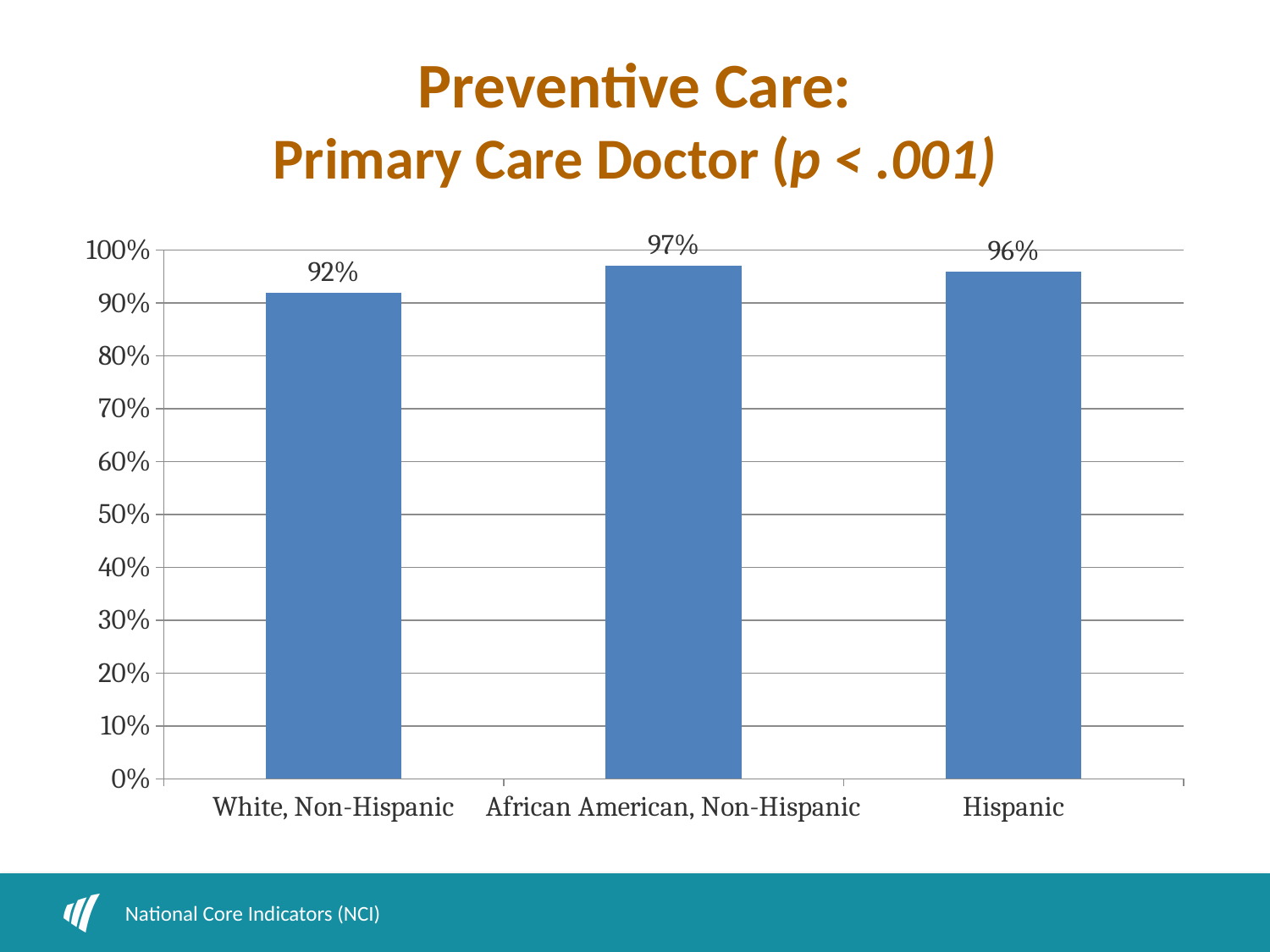
How many categories are shown on the x axis? 3 What is the difference between the values for African American, Non-Hispanic and White, Non-Hispanic? 5% Which category has the lowest value? White, Non-Hispanic What is the title of the chart on the slide? Preventive Care: Primary Care Doctor (p < .001) What is the difference between the values for Hispanic and White, Non-Hispanic? 4% What kind of chart is shown on the slide? bar chart Which is larger, the value for Hispanic or the value for White, Non-Hispanic? Hispanic What is the value for African American, Non-Hispanic? 97% Is the value for White, Non-Hispanic greater or less than 90%? greater Which category has the highest value? African American, Non-Hispanic What is the value for Hispanic? 96% What is the value for White, Non-Hispanic? 92%